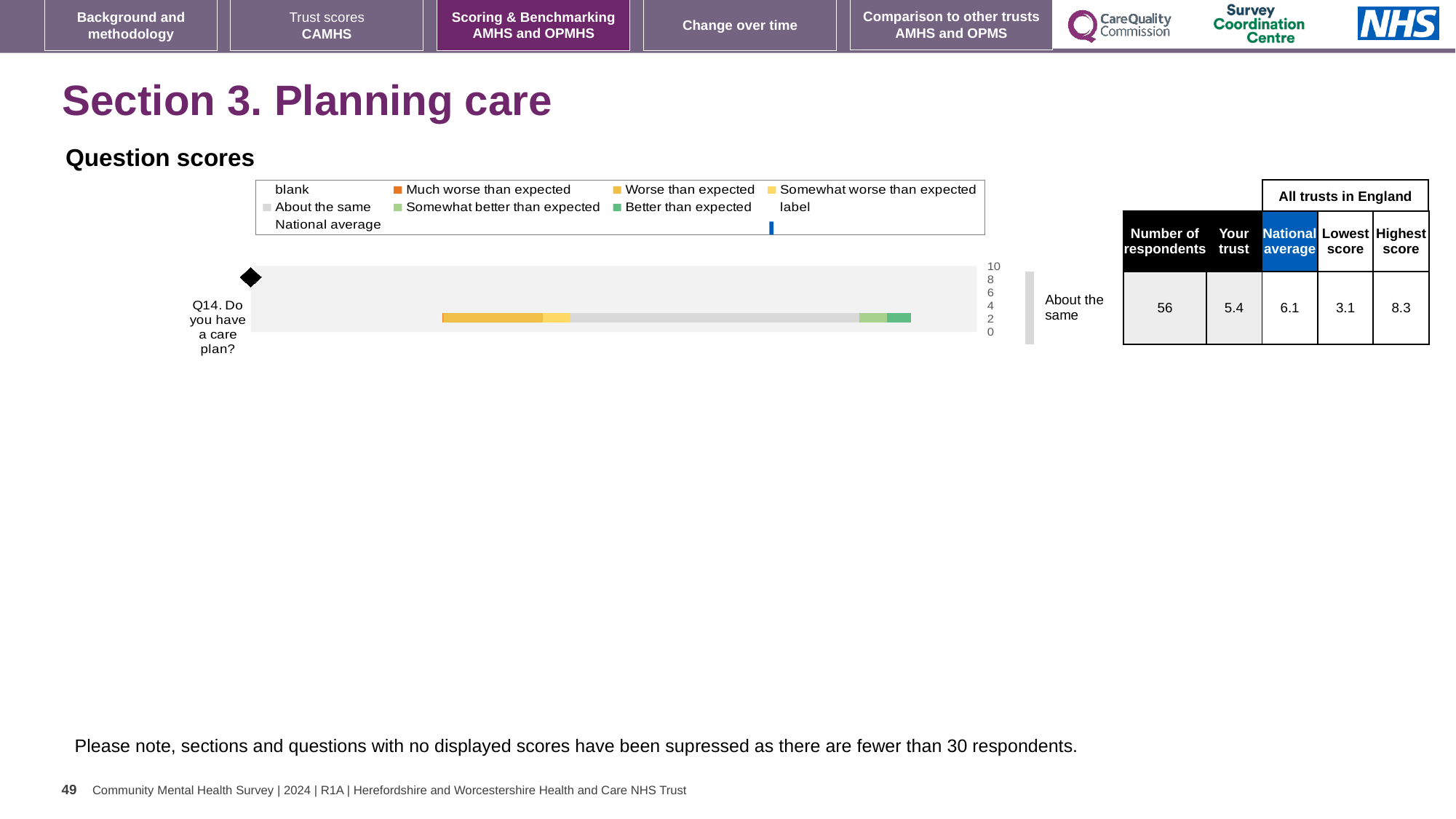
What is the number of respondents for Q14 'Do you have a care plan?' 56 What is the highest score among all trusts in England for Q14? 8.3 How many questions are plotted in the Question scores chart? 1 What is the national average score for Q14 'Do you have a care plan?' 6.1 How much higher is the national average than the 'Your trust' score for Q14? 0.7 Which benchmark category is shown next to the Q14 bar? About the same For Q14, which is larger: the 'Your trust' score or the national average? National average What kind of chart is used to show the Q14 question score? bar chart What is the 'Your trust' score for Q14 'Do you have a care plan?' 5.4 What is the difference between the highest score and the lowest score for Q14? 5.2 What is the lowest score among all trusts in England for Q14? 3.1 What is the maximum value shown on the score axis of the chart? 10